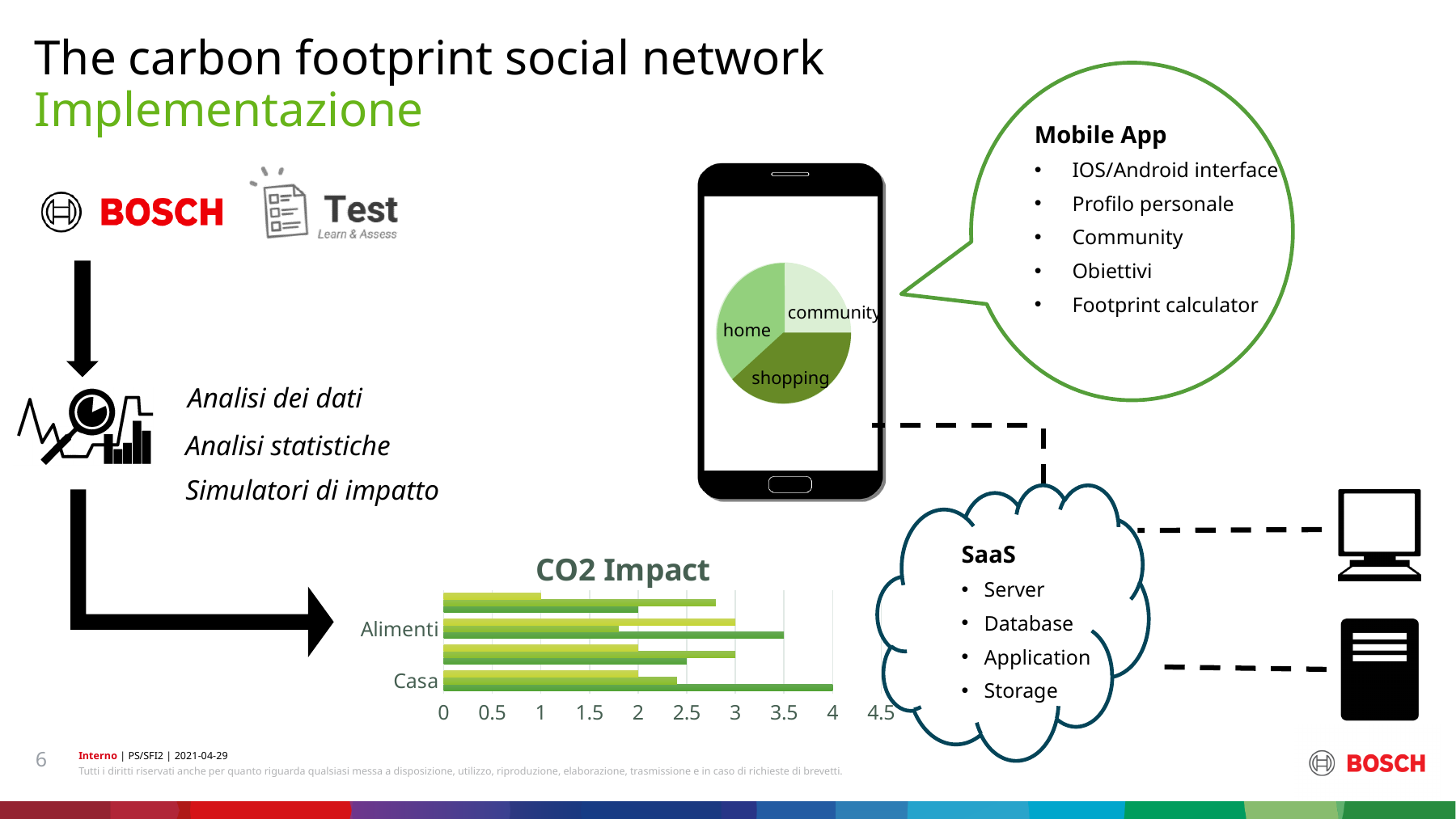
In the CO2 Impact chart, which labeled category has the longest bar overall? Casa How many slices does the pie chart on the phone screen have? 3 In the CO2 Impact chart, is the longest bar for Casa greater or less than 3? greater What kind of chart is shown on the phone screen? pie chart In the CO2 Impact chart, what is the highest value shown on the x axis? 4.5 In the CO2 Impact chart, which labeled category has the longest bar, Alimenti or Casa? Casa In the CO2 Impact chart, is the longest bar for Alimenti greater or less than 4? less What kind of chart is the CO2 Impact chart? bar chart What is the title of the bar chart at the bottom of the slide? CO2 Impact In the CO2 Impact chart, is the longest bar for Alimenti greater or less than 3? greater What are the labels of the slices in the pie chart on the phone screen? home, community, shopping